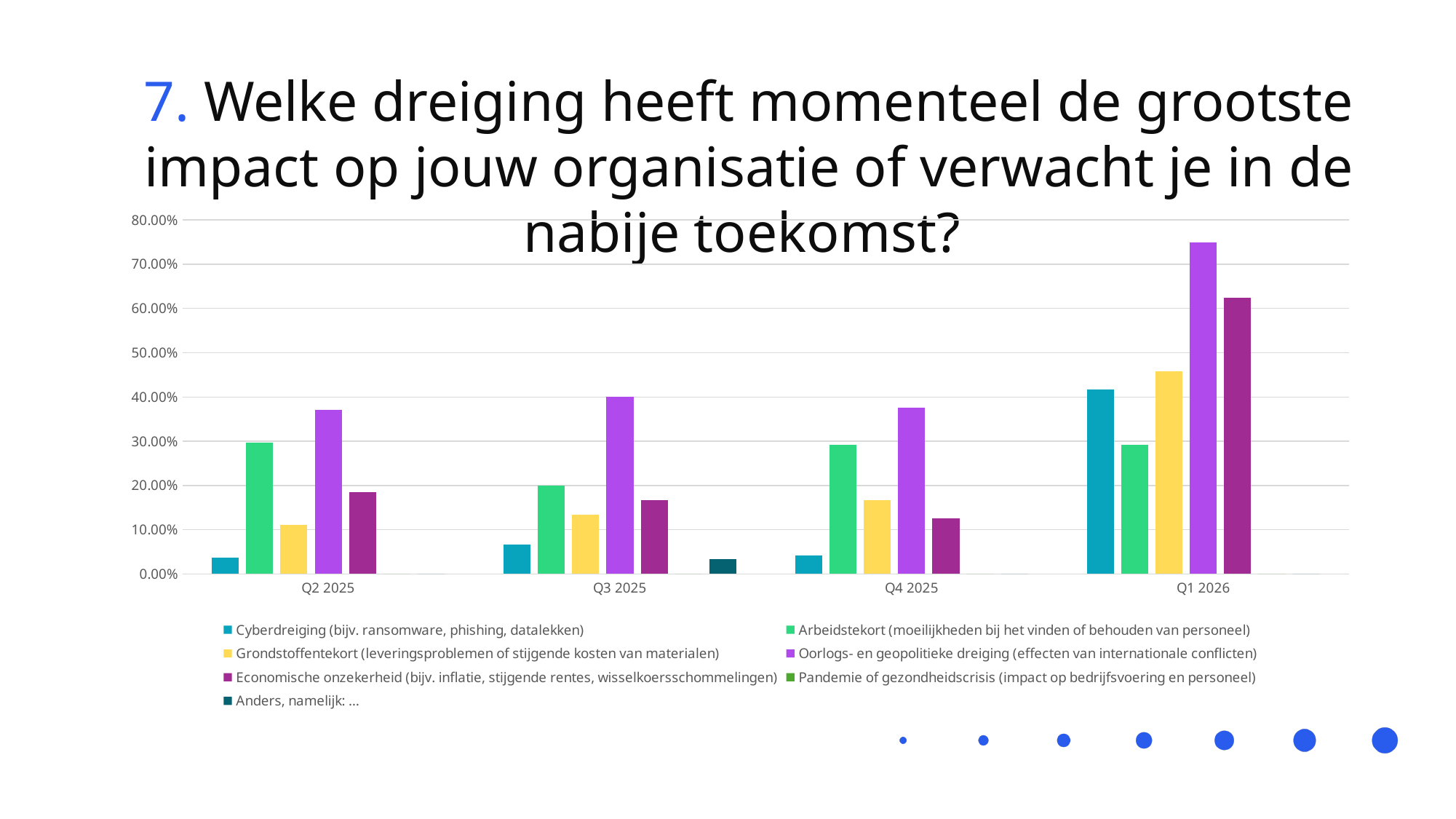
In Q1 2026, which of the plotted series has the lowest bar? Arbeidstekort Does the value for Oorlogs- en geopolitieke dreiging rise or fall from Q4 2025 to Q1 2026? rise In which quarter is the bar for Oorlogs- en geopolitieke dreiging the highest? Q1 2026 In Q1 2026, which is larger: Grondstoffentekort or Cyberdreiging? Grondstoffentekort What kind of chart is shown on the slide? bar chart Is the value for Economische onzekerheid in Q1 2026 greater or less than 50%? greater Is the value for Arbeidstekort in Q3 2025 greater or less than 30%? less Is the value for Cyberdreiging in Q1 2026 greater or less than 30%? greater How many quarters are shown on the x axis of the chart? 4 In Q2 2025, which is larger: Arbeidstekort or Grondstoffentekort? Arbeidstekort How many series does the legend of the chart list? 7